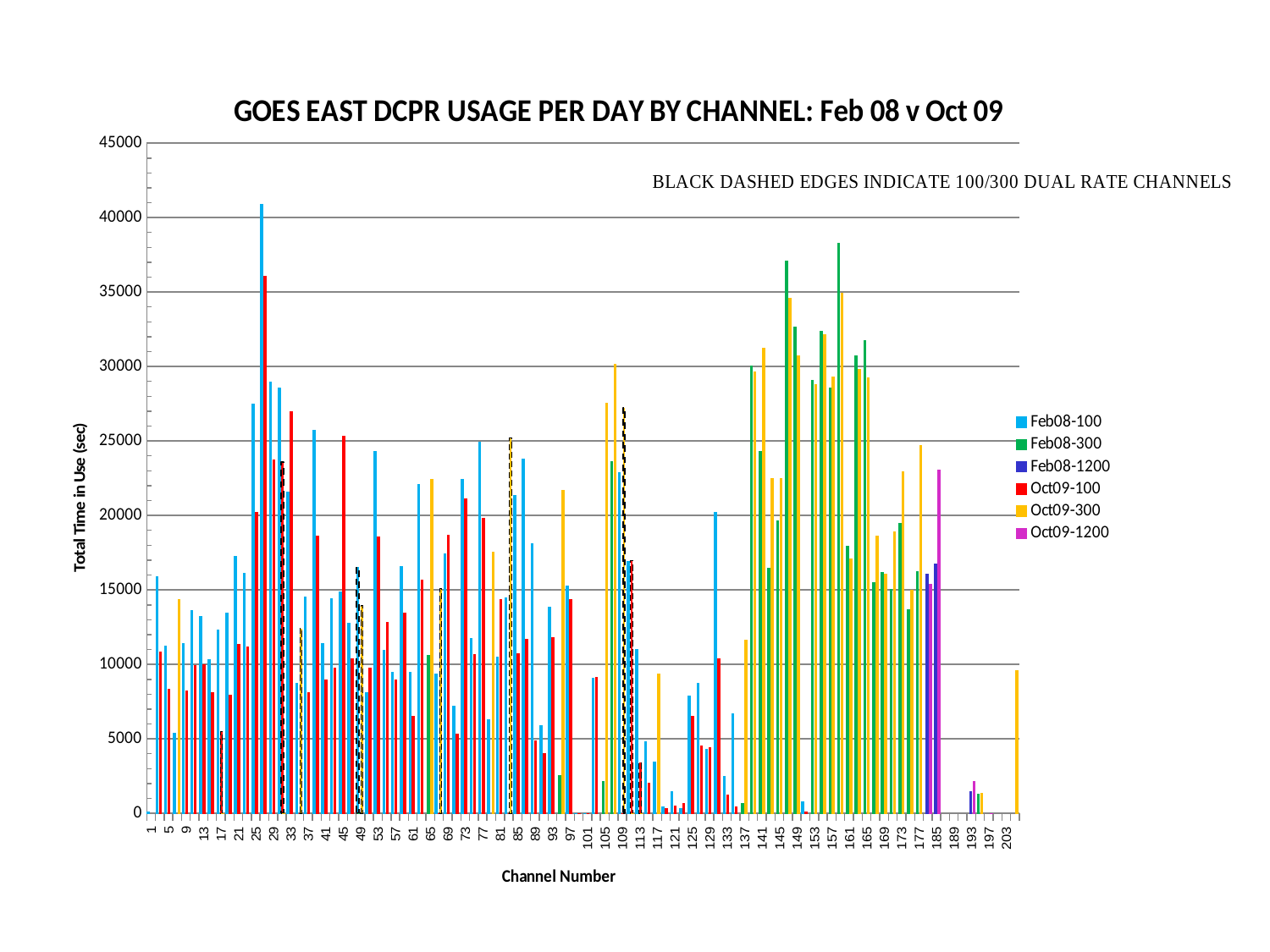
Is the tallest Oct09-300 bar greater or less than 30000? greater How many series does the legend list? 6 Is the tallest Feb08-300 bar greater or less than 35000? greater Which series contains the tallest bar on the chart? Feb08-100 Is the tallest Oct09-1200 bar greater or less than 20000? greater Which is taller: the tallest Feb08-100 bar or the tallest Feb08-300 bar? Feb08-100 Which is taller: the tallest Oct09-1200 bar or the tallest Feb08-1200 bar? Oct09-1200 What is the label of the vertical axis? Total Time in Use (sec) What is the title of the chart? GOES EAST DCPR USAGE PER DAY BY CHANNEL: Feb 08 v Oct 09 What kind of chart is shown on the slide? bar chart